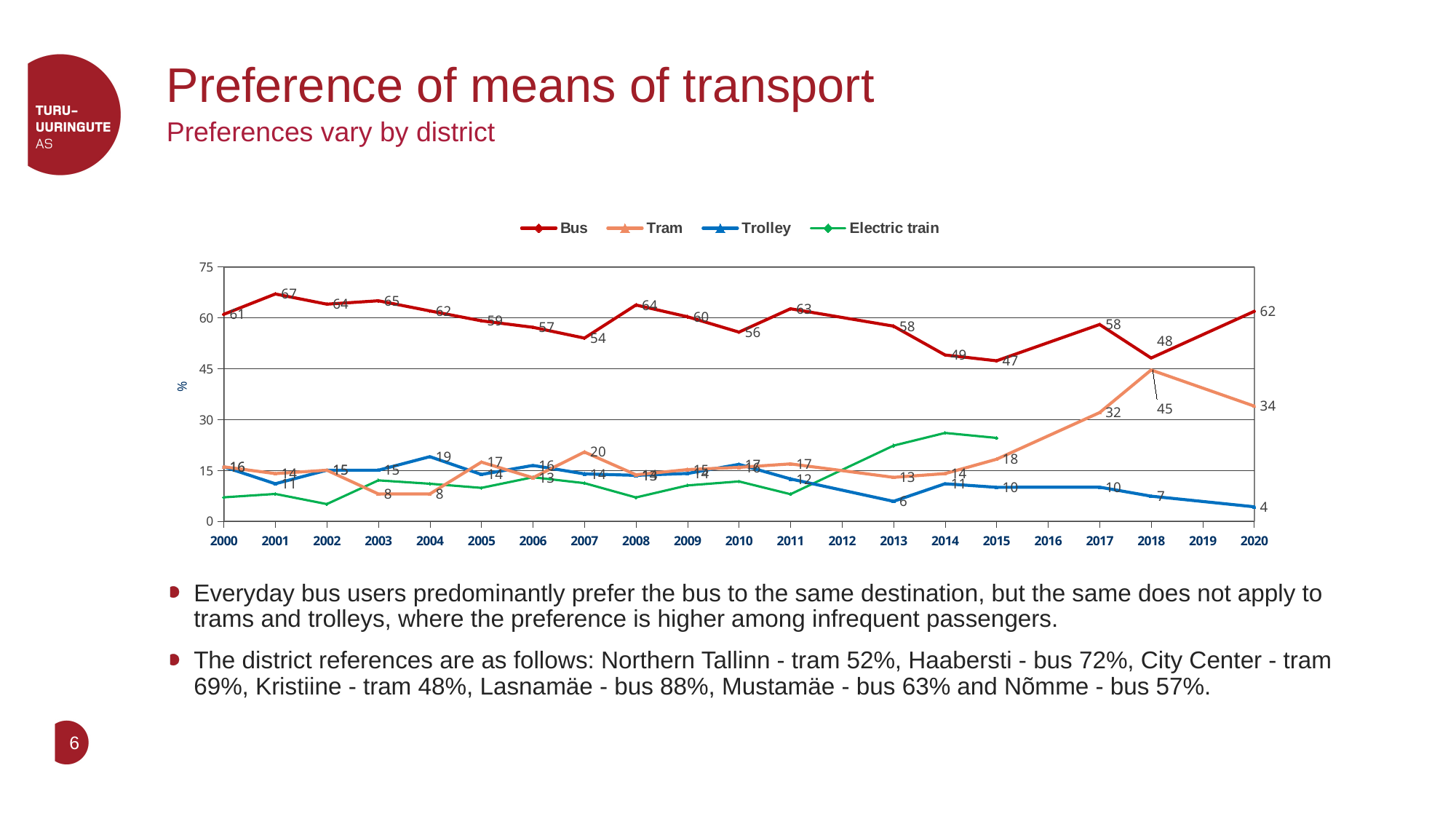
Is the Electric train value in 2014 greater or less than 15? greater Which is larger in 2017, the Bus value or the Tram value? Bus How many series does the legend list? 4 What is the Trolley value in 2020? 4 In which year does the Bus series reach its highest value? 2001 What is the Bus value in 2007? 54 What is the Bus value in 2020? 62 What is the difference between the Bus and Tram values in 2020? 28 In which year does the Bus series reach its lowest value? 2015 Does the Trolley series rise or fall from 2014 to 2020? fall What is the Tram value in 2018? 45 What kind of chart is shown on the slide? line chart